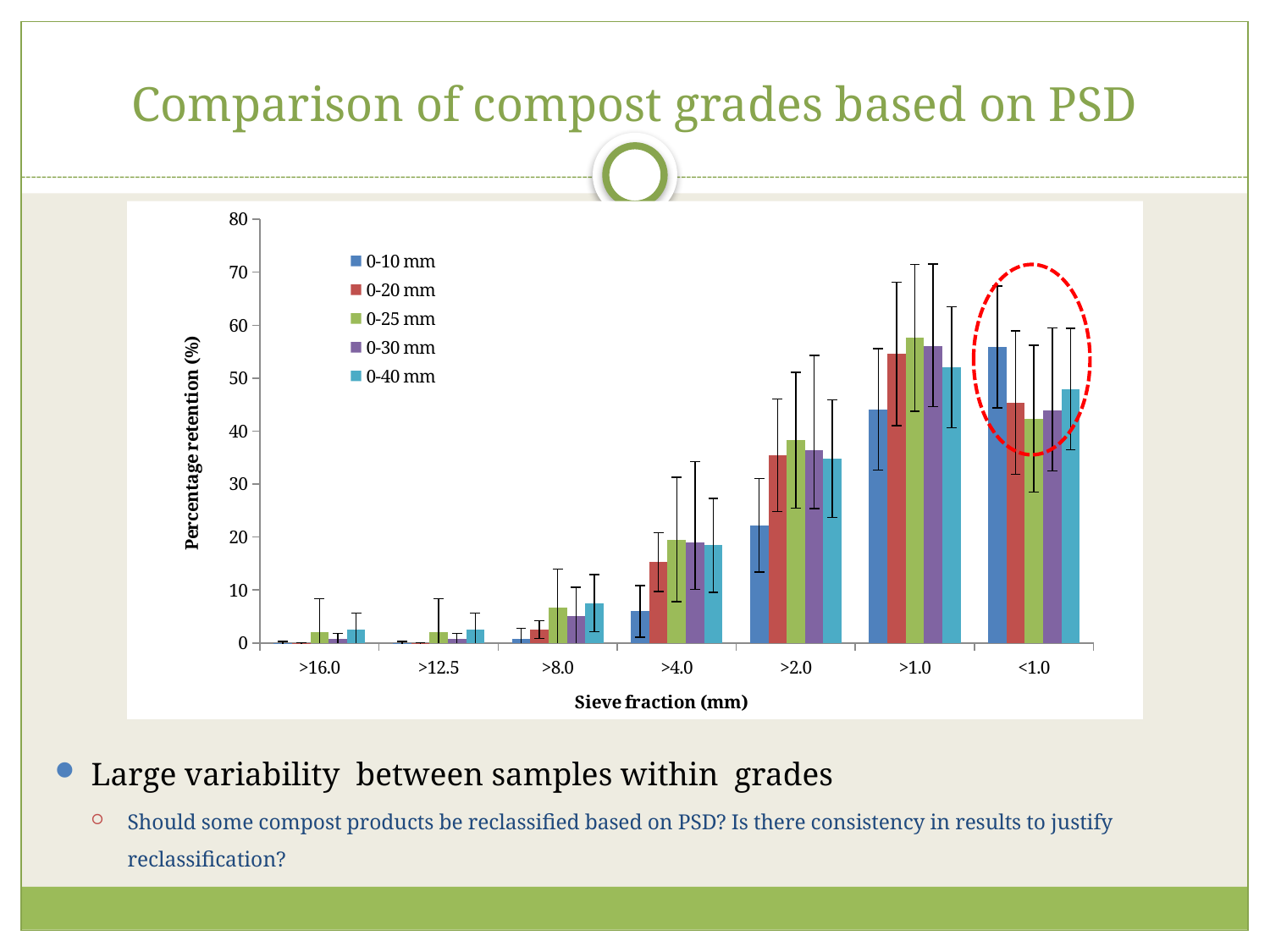
Does the percentage retention for 0-10 mm rise or fall from the >16.0 sieve fraction to the >1.0 sieve fraction? rise Is the value for 0-40 mm at the >4.0 sieve fraction greater or less than 10? greater What is the title of the y axis? Percentage retention (%) At the <1.0 sieve fraction, which is larger: the value for 0-10 mm or the value for 0-25 mm? 0-10 mm Is the value for 0-10 mm at the >2.0 sieve fraction greater or less than 30? less How many sieve fraction categories are shown on the x axis? 7 How many series does the legend list? 5 At the <1.0 sieve fraction, which compost grade has the highest percentage retention? 0-10 mm At the >1.0 sieve fraction, which compost grade has the lowest percentage retention? 0-10 mm Is the value for 0-25 mm at the >1.0 sieve fraction greater or less than 50? greater What kind of chart is shown on the slide? bar chart